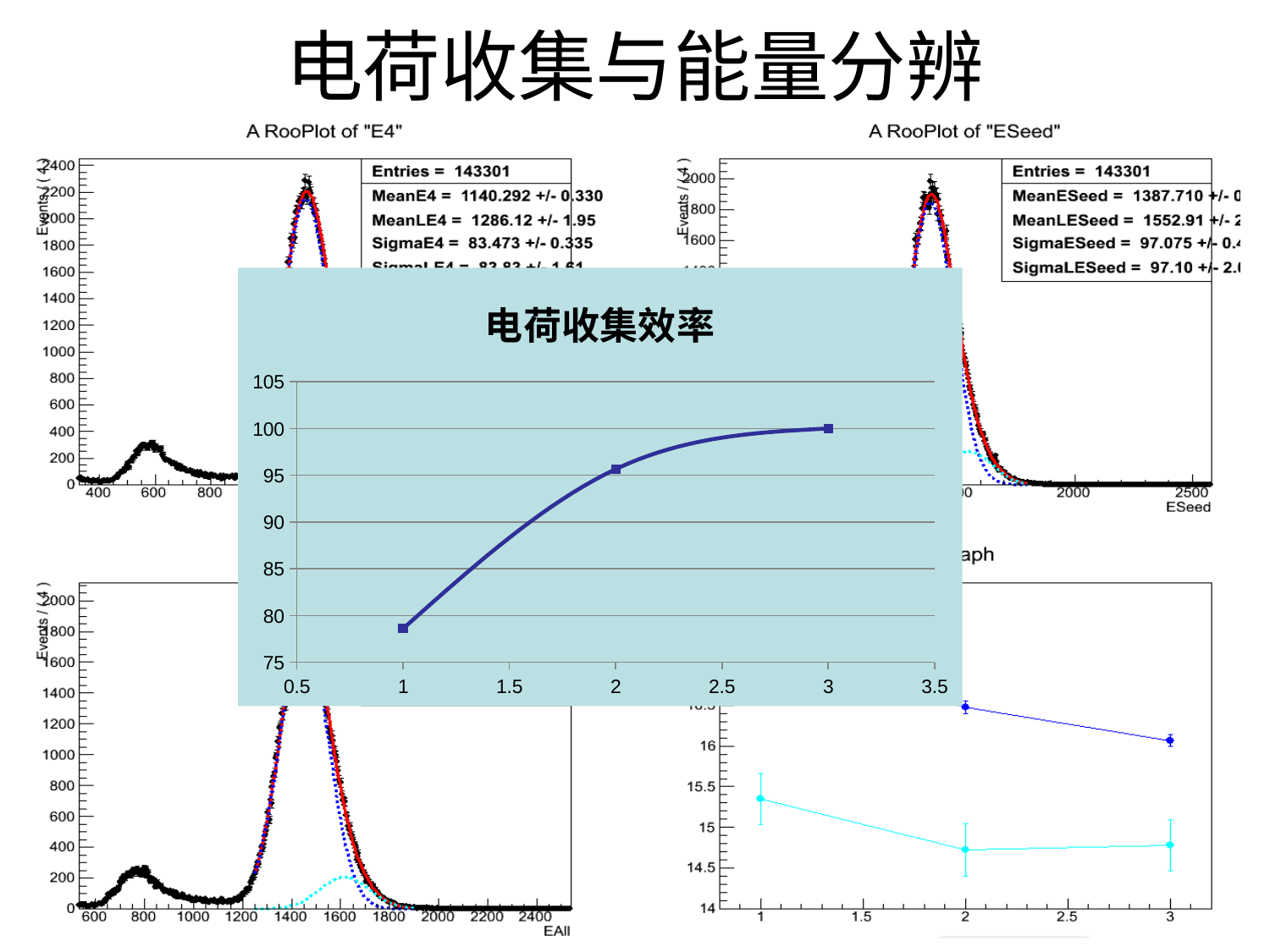
In the chart titled 电荷收集效率, is the value at x = 2 greater or less than 90? greater In the chart titled 电荷收集效率, do the values rise or fall as x increases from 1 to 3? rise What kind of chart is the chart titled 电荷收集效率? line chart In the chart titled 电荷收集效率, at which x value is the plotted value lowest? 1 In the chart titled 电荷收集效率, how many data points are plotted? 3 In the chart titled 电荷收集效率, what is the highest value shown on the y axis? 105 In the bottom-right chart, is the cyan line's value at x = 2 greater or less than 15? less In the chart titled A RooPlot of "E4", what is the value of MeanE4 shown in the statistics box? 1140.292 +/- 0.330 In the chart titled A RooPlot of "E4", what is the number of Entries shown in the statistics box? 143301 In the chart titled 电荷收集效率, which is larger, the value at x = 2 or the value at x = 3? x = 3 In the chart titled 电荷收集效率, is the value at x = 1 greater or less than 80? less In the chart titled 电荷收集效率, at which x value is the plotted value highest? 3